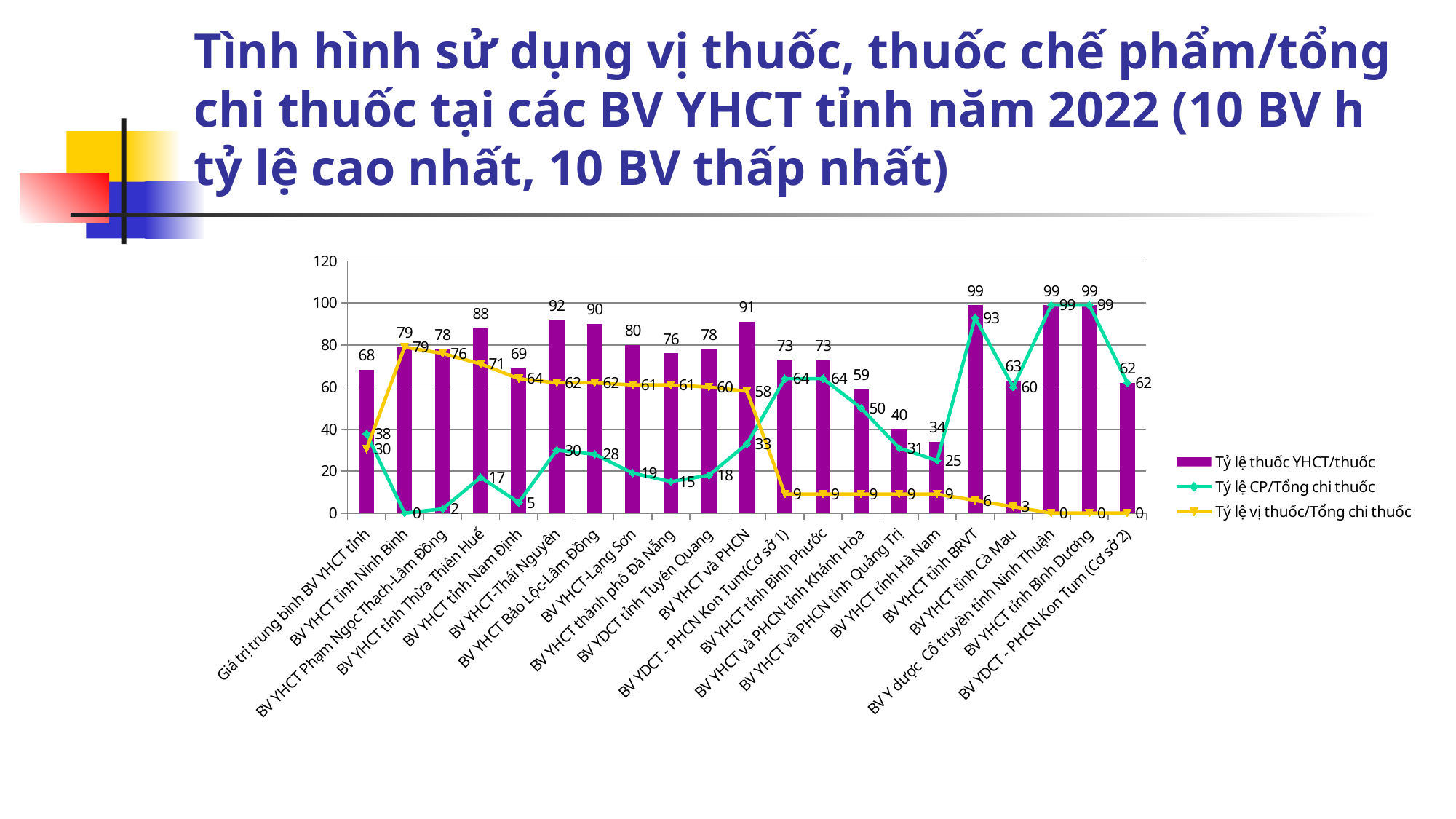
What is the value of Tỷ lệ vị thuốc/Tổng chi thuốc for BV YHCT tỉnh Ninh Bình? 79 What is the value of Tỷ lệ CP/Tổng chi thuốc for BV YHCT tỉnh BRVT? 93 How many categories are shown on the x axis of the chart? 21 What is the Tỷ lệ thuốc YHCT/thuốc value for Giá trị trung bình BV YHCT tỉnh? 68 Which category has the highest value on the Tỷ lệ vị thuốc/Tổng chi thuốc line? BV YHCT tỉnh Ninh Bình What is the value of Tỷ lệ thuốc YHCT/thuốc for BV YHCT tỉnh Thừa Thiên Huế? 88 Do the Tỷ lệ thuốc YHCT/thuốc bars rise or fall from BV YHCT và PHCN tỉnh Khánh Hòa to BV YHCT tỉnh Hà Nam? Fall How many series does the legend list? 3 What is the difference between the Tỷ lệ thuốc YHCT/thuốc values for BV YHCT-Thái Nguyên and BV YHCT tỉnh Hà Nam? 58 What kind of chart is shown on the slide? A combined bar and line chart Which category has the lowest Tỷ lệ thuốc YHCT/thuốc bar? BV YHCT tỉnh Hà Nam Which has the larger Tỷ lệ thuốc YHCT/thuốc value, BV YHCT-Lạng Sơn or BV YHCT thành phố Đà Nẵng? BV YHCT-Lạng Sơn